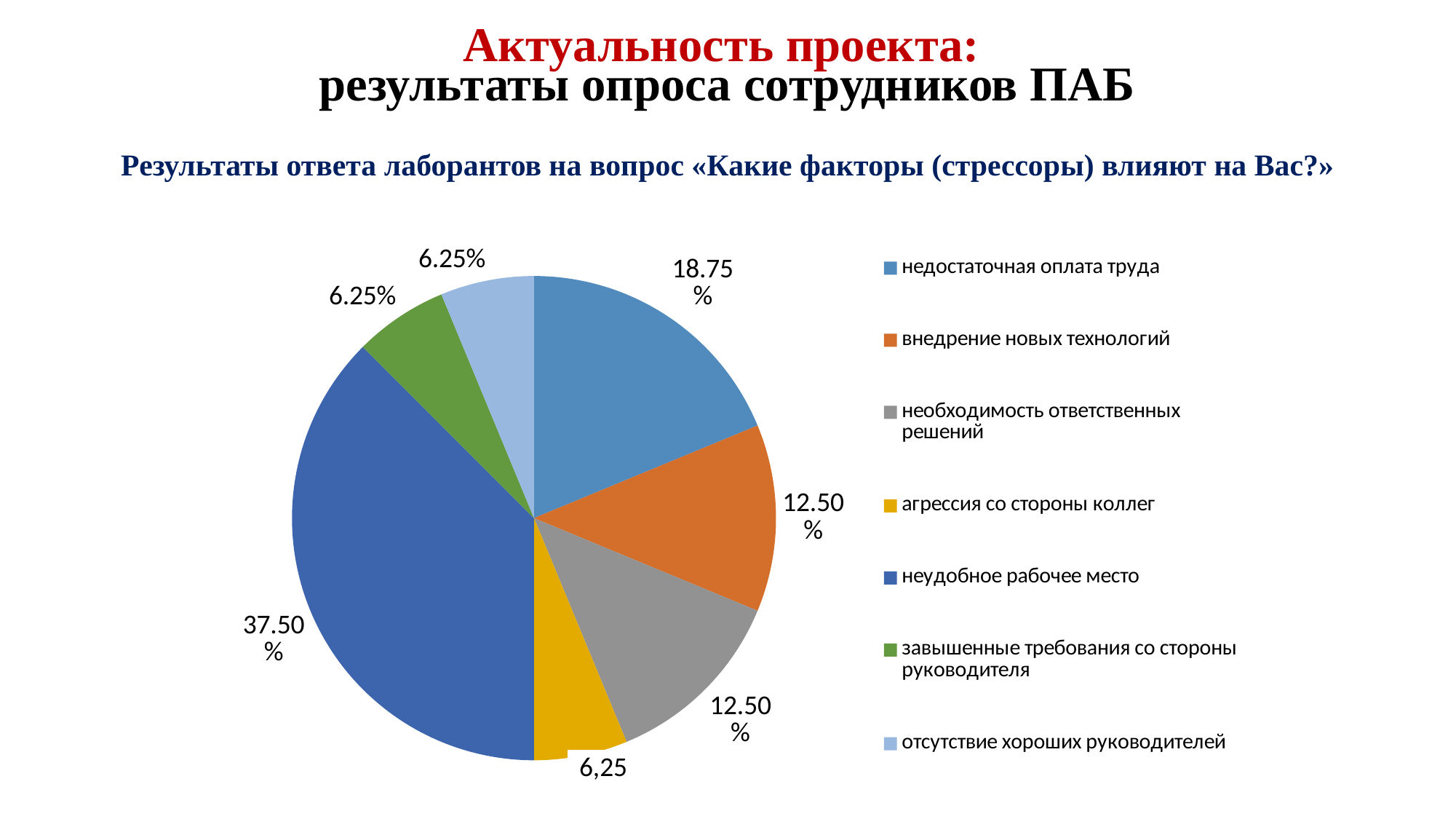
What is the difference between the share for «неудобное рабочее место» and the share for «недостаточная оплата труда»? 18.75% What value is shown for «агрессия со стороны коллег»? 6,25 How many categories does the legend of the pie chart list? 7 What share of the pie does «внедрение новых технологий» have? 12.50% Which is larger: the slice for «недостаточная оплата труда» or the slice for «необходимость ответственных решений»? недостаточная оплата труда What share of the pie does «неудобное рабочее место» have? 37.50% Which category has the largest slice of the pie? неудобное рабочее место What is the difference between the share for «недостаточная оплата труда» and the share for «внедрение новых технологий»? 6.25% What kind of chart is shown on the slide? pie chart What share of the pie does «недостаточная оплата труда» have? 18.75% Which colour represents «завышенные требования со стороны руководителя» in the pie chart? green What share of the pie does «отсутствие хороших руководителей» have? 6.25%